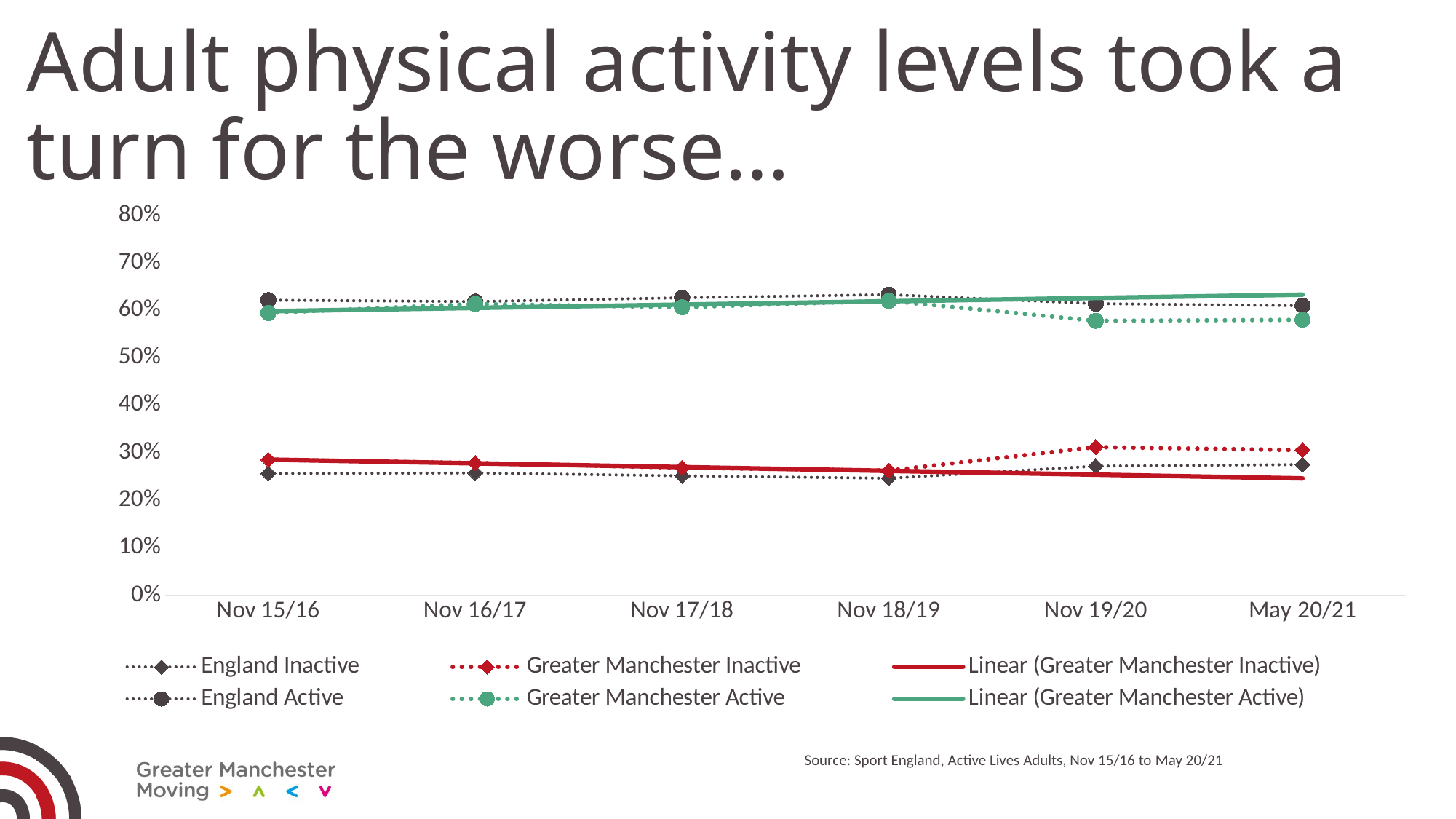
Does the Greater Manchester Active line rise or fall between Nov 18/19 and Nov 19/20? Fall Is the value for England Inactive at Nov 18/19 greater or less than 30%? less Is the value for Greater Manchester Inactive at Nov 19/20 greater or less than 20%? greater At Nov 19/20, which is higher: Greater Manchester Inactive or England Inactive? Greater Manchester Inactive What colour is used for the Greater Manchester Active series? Green What kind of chart is shown on the slide? Line chart Is the value for England Active at Nov 15/16 greater or less than 60%? greater How many entries does the legend list? 6 How many time points are shown on the x axis? 6 At May 20/21, which is higher: England Active or Greater Manchester Active? England Active Does the Greater Manchester Inactive line rise or fall between Nov 18/19 and Nov 19/20? Rise